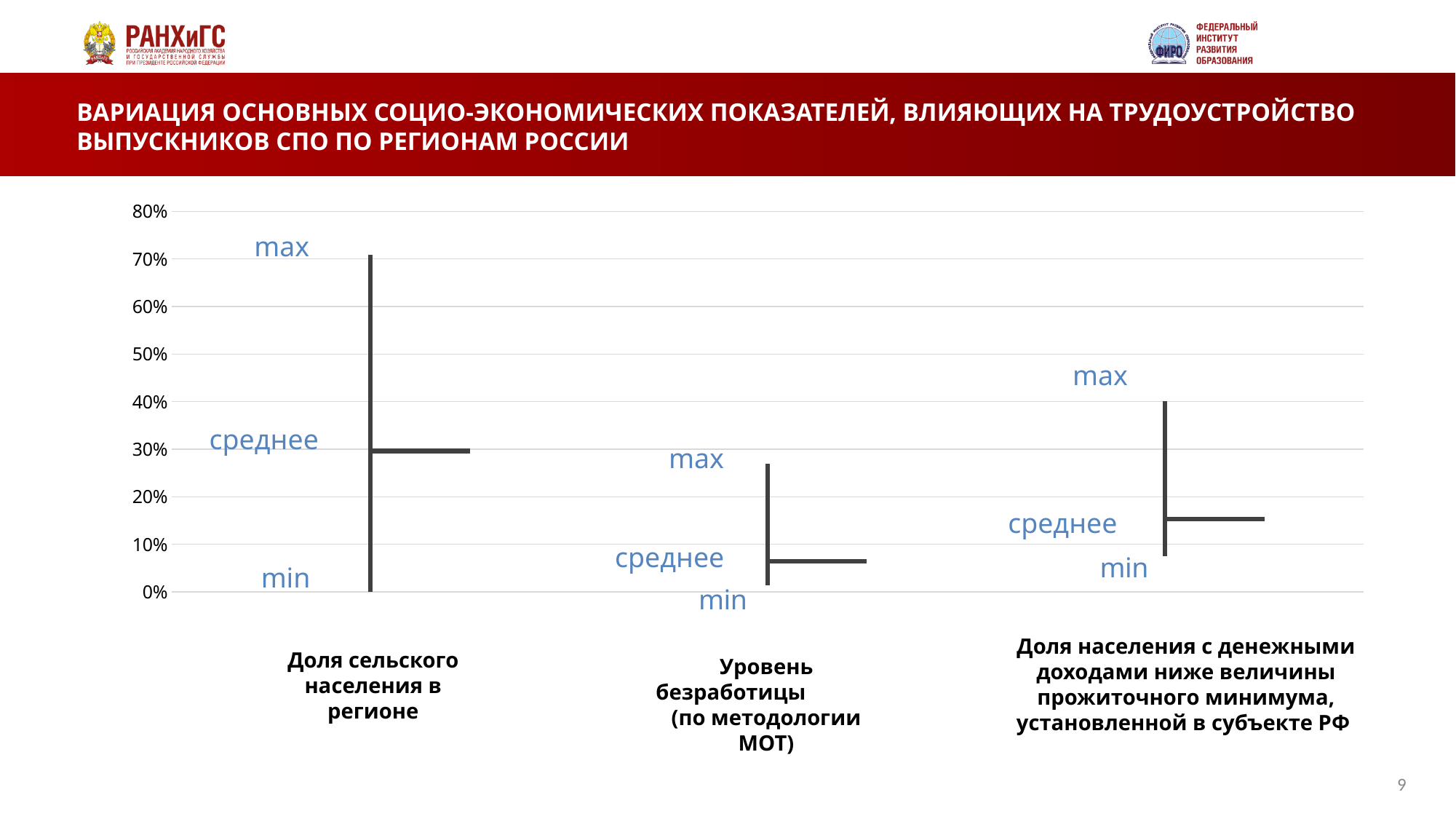
Which indicator has the lowest maximum value on the chart? Уровень безработицы (по методологии МОТ) Is the average (среднее) value for 'Уровень безработицы (по методологии МОТ)' greater or less than 10%? less Is the max value for 'Доля населения с денежными доходами ниже величины прожиточного минимума' greater or less than 30%? greater Which indicator has the highest average (среднее) value? Доля сельского населения в регионе Which indicator has the lowest average (среднее) value? Уровень безработицы (по методологии МОТ) Which indicator has the highest maximum value on the chart? Доля сельского населения в регионе Which is larger: the max value for 'Доля сельского населения в регионе' or the max value for 'Уровень безработицы (по методологии МОТ)'? Доля сельского населения в регионе Is the average (среднее) value for 'Доля населения с денежными доходами ниже величины прожиточного минимума' greater or less than 20%? less What is the highest value shown on the vertical axis of the chart? 80% How many categories (indicators) are plotted on the chart? 3